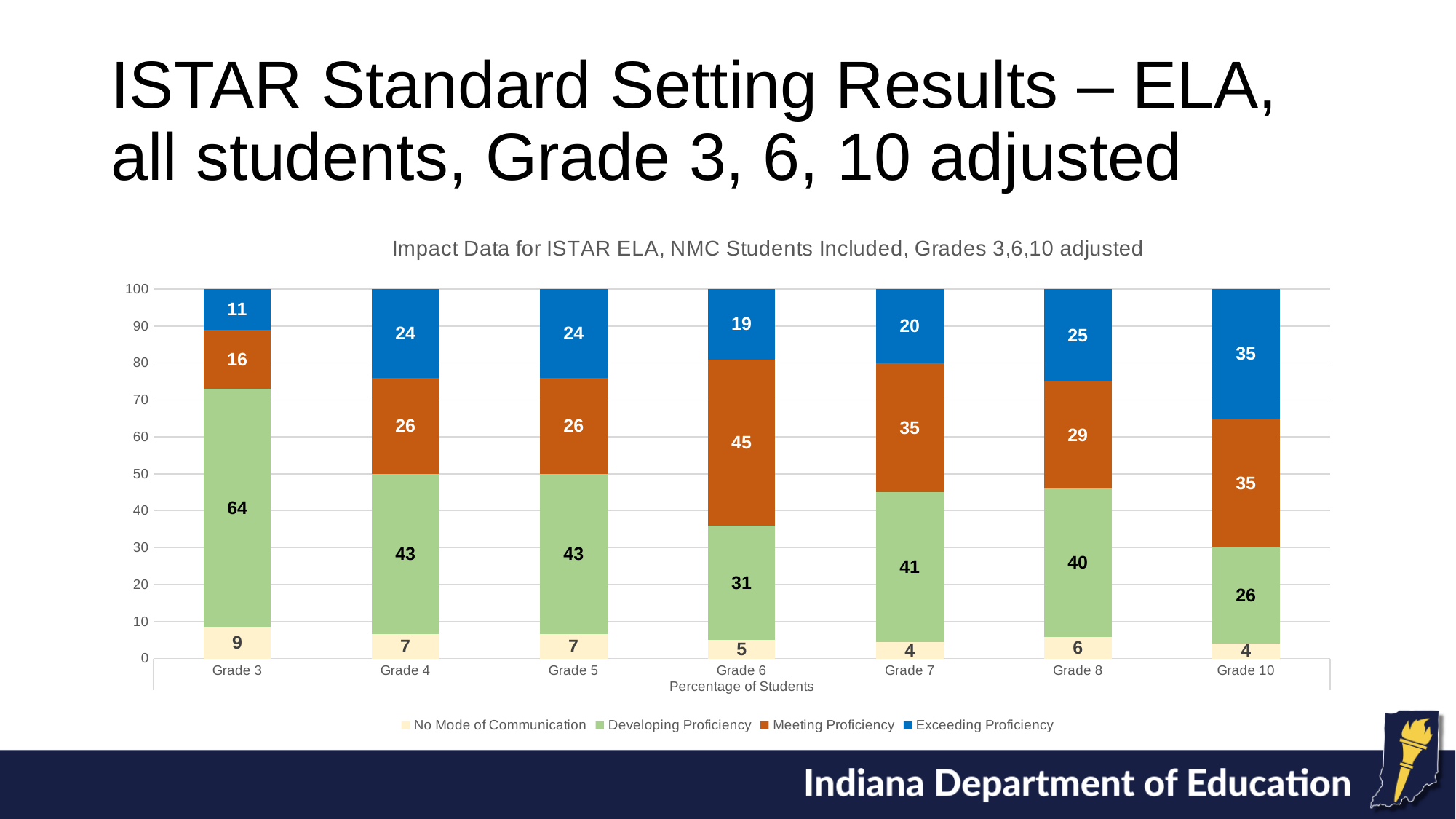
What is the value for Exceeding Proficiency for Grade 10? 35 What is the total of the stacked bar for Grade 6? 100 What is the value for Meeting Proficiency for Grade 6? 45 Which has the larger Developing Proficiency value, Grade 4 or Grade 8? Grade 4 What kind of chart is shown on the slide? Stacked bar chart Which grade has the lowest value for Exceeding Proficiency? Grade 3 What is the value for Developing Proficiency for Grade 3? 64 What is the value for No Mode of Communication for Grade 3? 9 Which grade has the highest value for Exceeding Proficiency? Grade 10 How many grade categories are shown on the x axis? 7 What is the difference between the Meeting Proficiency values for Grade 7 and Grade 3? 19 How many series does the legend list? 4